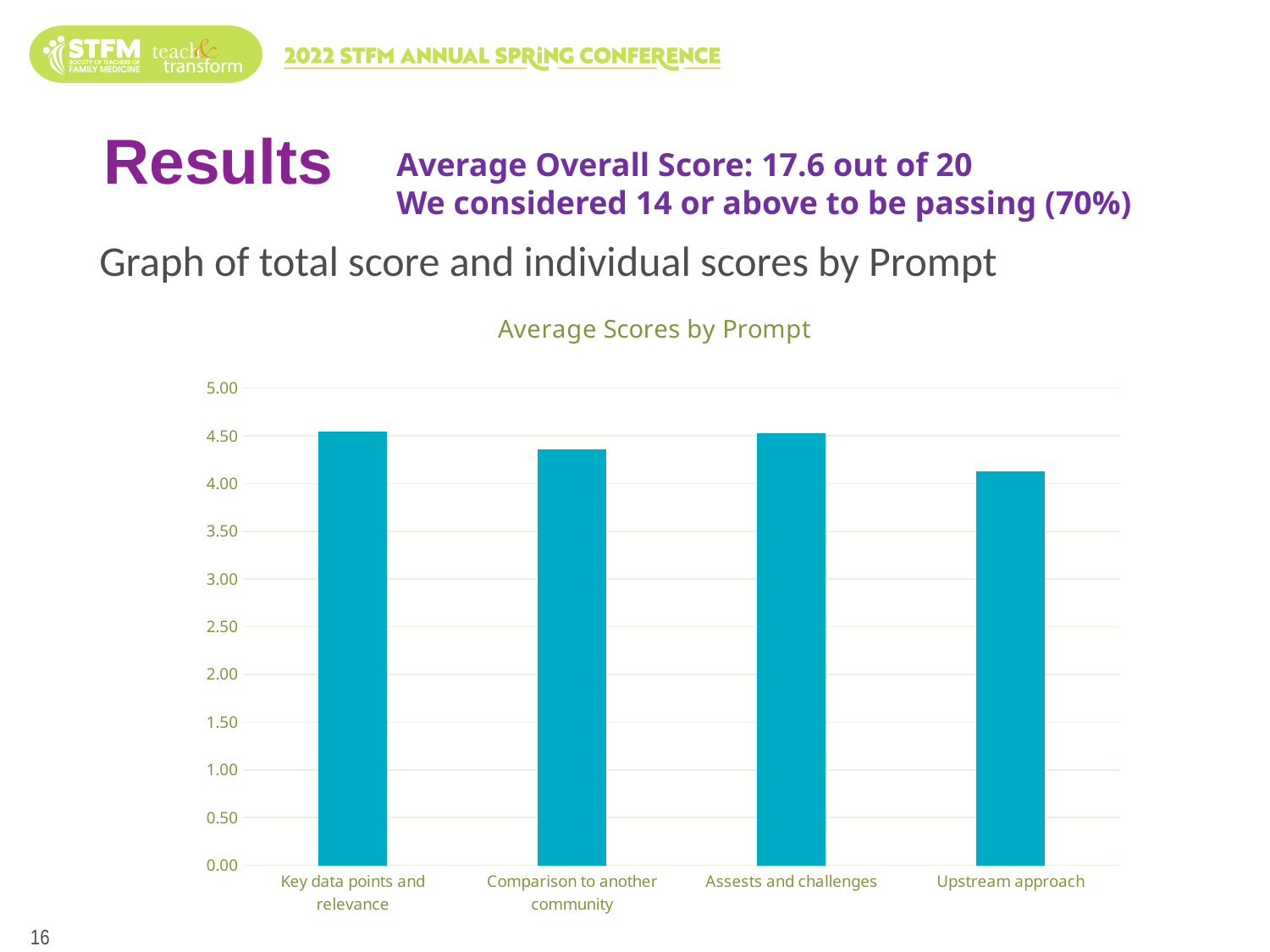
Is the value for Assests and challenges greater or less than 4.00? greater Is the value for Comparison to another community greater or less than 4.50? less What kind of chart is shown on the slide? bar chart What is the title of the chart? Average Scores by Prompt Is the value for Key data points and relevance greater or less than 5.00? less Which has a higher average score: Assests and challenges or Upstream approach? Assests and challenges Which prompt has the lowest average score? Upstream approach How many prompts (categories) are shown on the x axis of the chart? 4 Which has a higher average score: Key data points and relevance or Comparison to another community? Key data points and relevance Which has a higher average score: Comparison to another community or Upstream approach? Comparison to another community What is the highest value shown on the y axis of the chart? 5.00